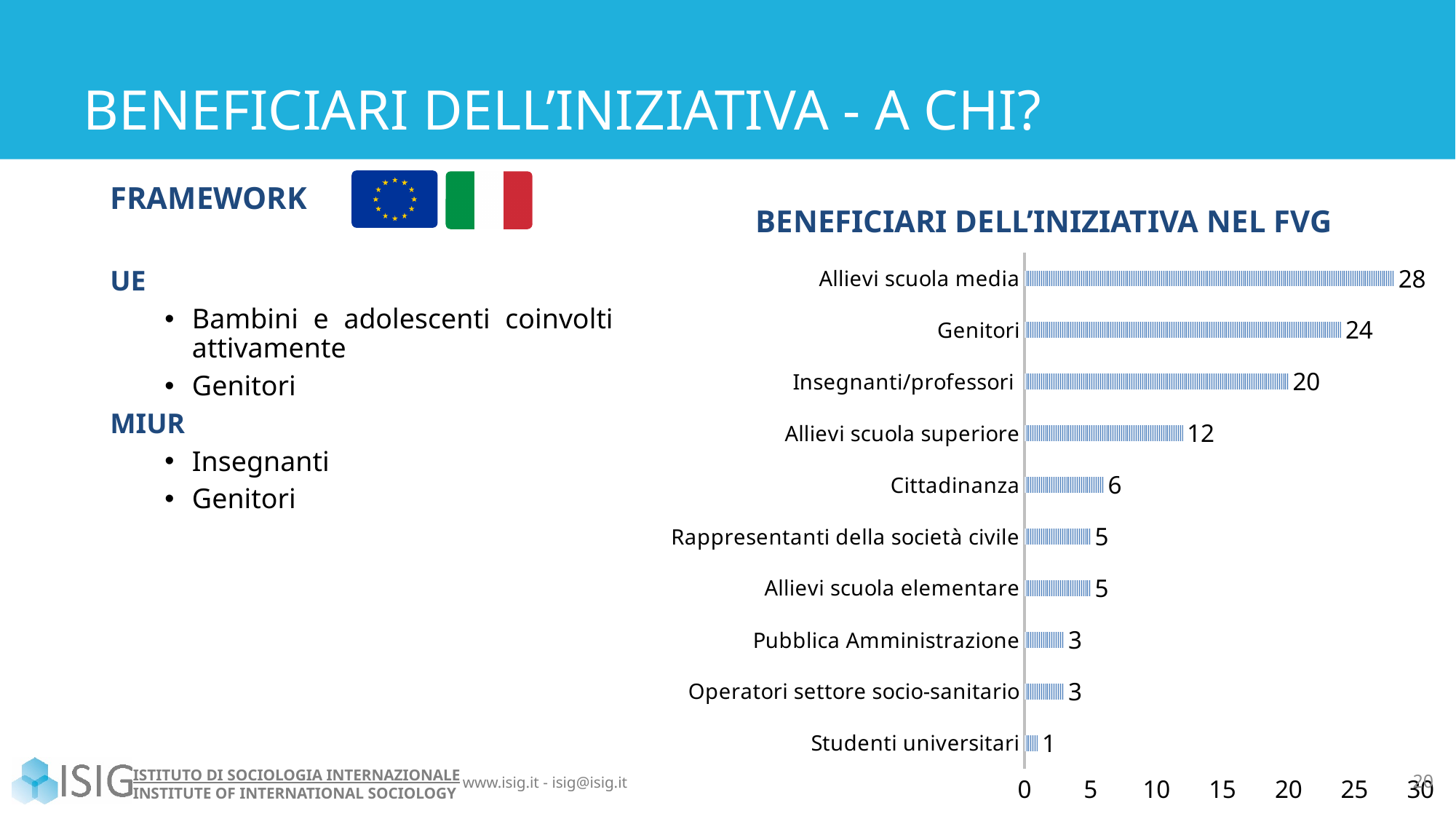
What is the title of the chart? BENEFICIARI DELL'INIZIATIVA NEL FVG What kind of chart is shown on the slide? bar chart What is the difference between the values for Genitori and Allievi scuola superiore? 12 What is the value for Cittadinanza? 6 Is the value for Allievi scuola superiore greater or less than 10? greater Which category has the highest value? Allievi scuola media Which is larger, the value for Genitori or the value for Insegnanti/professori? Genitori What is the value for Insegnanti/professori? 20 How many categories are shown in the chart? 10 Which category has the lowest value? Studenti universitari What is the value for Pubblica Amministrazione? 3 What is the value for Allievi scuola media? 28